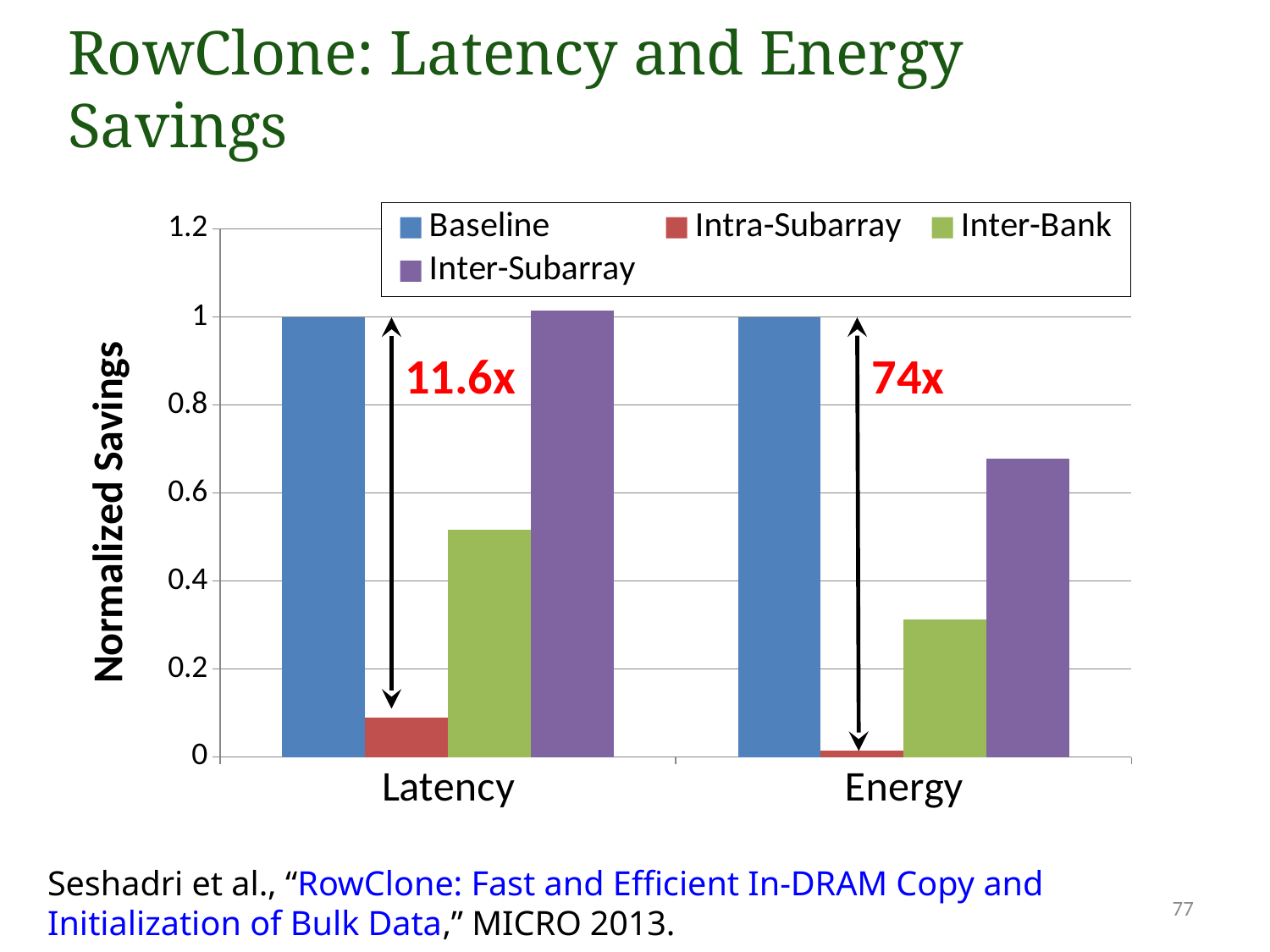
Which series has the highest value for Energy? Baseline Is the Inter-Bank value for Energy greater or less than 0.4? less How many series does the legend list? 4 Is the Inter-Subarray value for Energy greater or less than 0.6? greater What is the y-axis title of the chart? Normalized Savings Which series has the lowest value for Energy? Intra-Subarray How many categories are shown on the x axis? 2 What is the Baseline value for Energy? 1 Is the Inter-Bank value larger for Latency or for Energy? Latency What is the Baseline value for Latency? 1 Is the Inter-Bank value for Latency greater or less than 0.4? greater What kind of chart is shown on the slide? bar chart